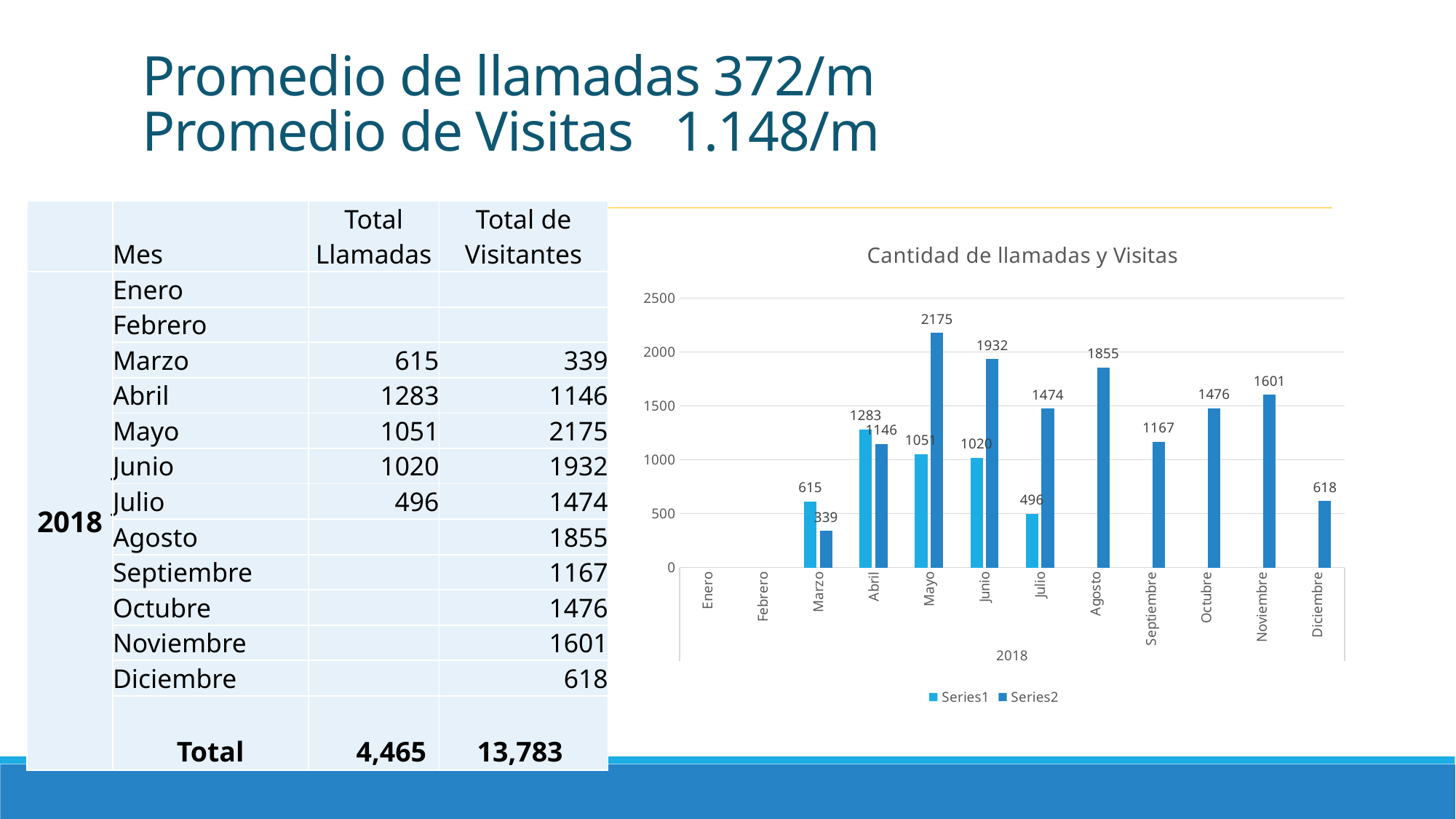
Which is larger, the Series1 value for Mayo or the Series2 value for Mayo? Series2 value for Mayo What is the value of Series1 for Abril? 1283 How many months are shown on the x axis of the chart? 12 What is the title of the chart? Cantidad de llamadas y Visitas What is the value of Series2 for Noviembre? 1601 Is the Series2 value for Agosto greater or less than 1500? greater What is the difference between the Series2 values for Junio and Julio? 458 What kind of chart is shown on the slide? Bar chart Which month has the highest Series2 value? Mayo What is the value of Series2 for Mayo? 2175 How many series does the legend list? 2 Which month has the lowest Series1 value? Julio